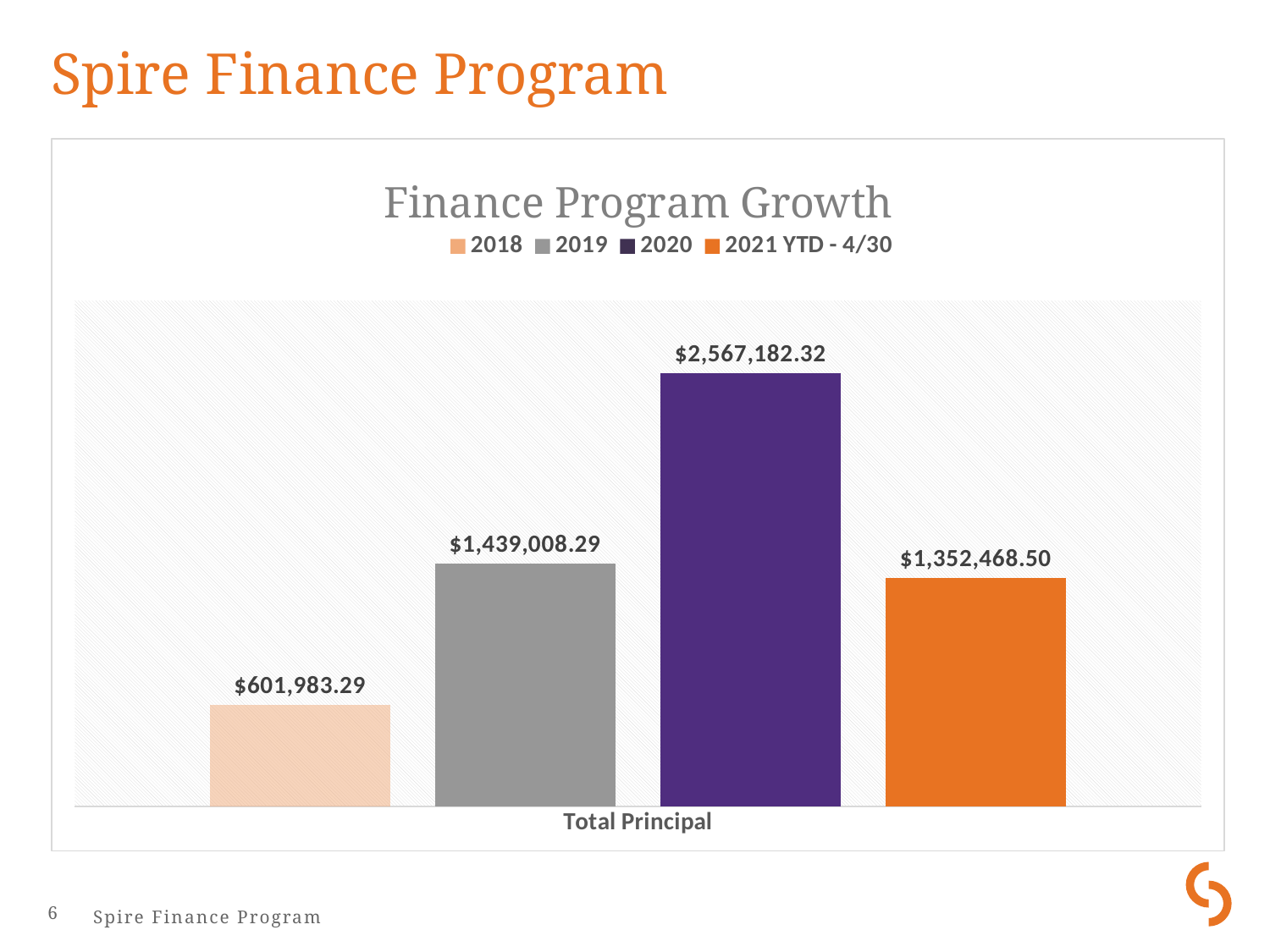
What is the Total Principal value for 2019? $1,439,008.29 What is the Total Principal value for 2021 YTD - 4/30? $1,352,468.50 What kind of chart is shown on the slide? Bar chart What is the Total Principal value for 2018 in the Finance Program Growth chart? $601,983.29 Which is larger, the Total Principal for 2019 or for 2021 YTD - 4/30? 2019 What is the difference between the 2020 and 2019 Total Principal values? $1,128,174.03 Which series has the lowest Total Principal? 2018 How many series does the legend list? 4 What is the title of the chart? Finance Program Growth What is the difference between the 2019 and 2018 Total Principal values? $837,025.00 Which series has the highest Total Principal? 2020 What is the Total Principal value for 2020? $2,567,182.32